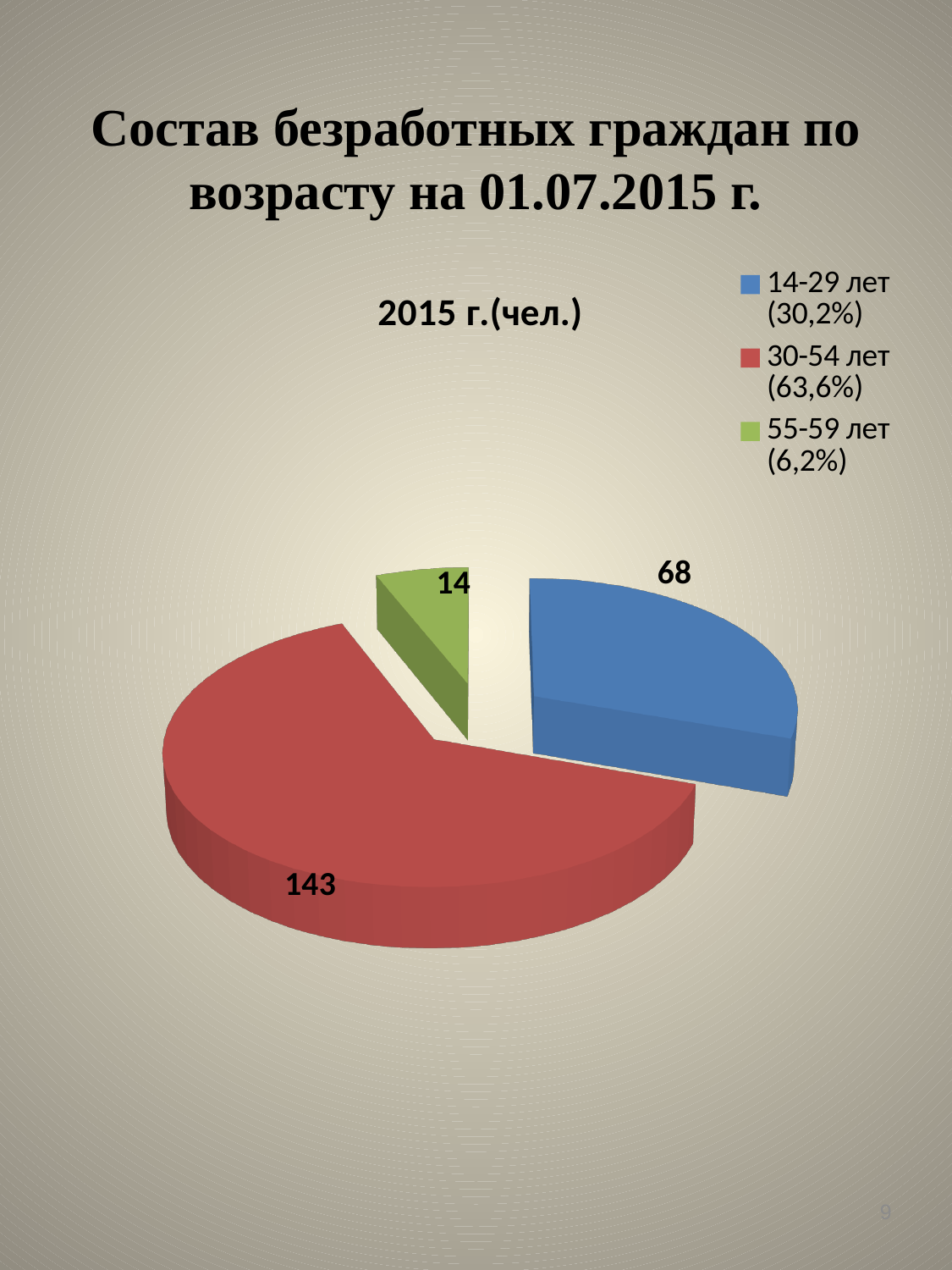
What is the value for the 14-29 лет slice? 68 What is the value for the 55-59 лет slice? 14 How many slices does the pie chart have? 3 What is the difference between the values for 30-54 лет and 14-29 лет? 75 What share of the pie does the 30-54 лет slice represent, according to the legend? 63,6% What kind of chart is shown on the slide? pie chart Which age group has the smallest slice? 55-59 лет Which age group has the largest slice? 30-54 лет What is the title shown above the pie chart? 2015 г.(чел.) What is the value for the 30-54 лет slice? 143 Which is larger, the value for 14-29 лет or for 55-59 лет? 14-29 лет What share of the pie does the 55-59 лет slice represent, according to the legend? 6,2%